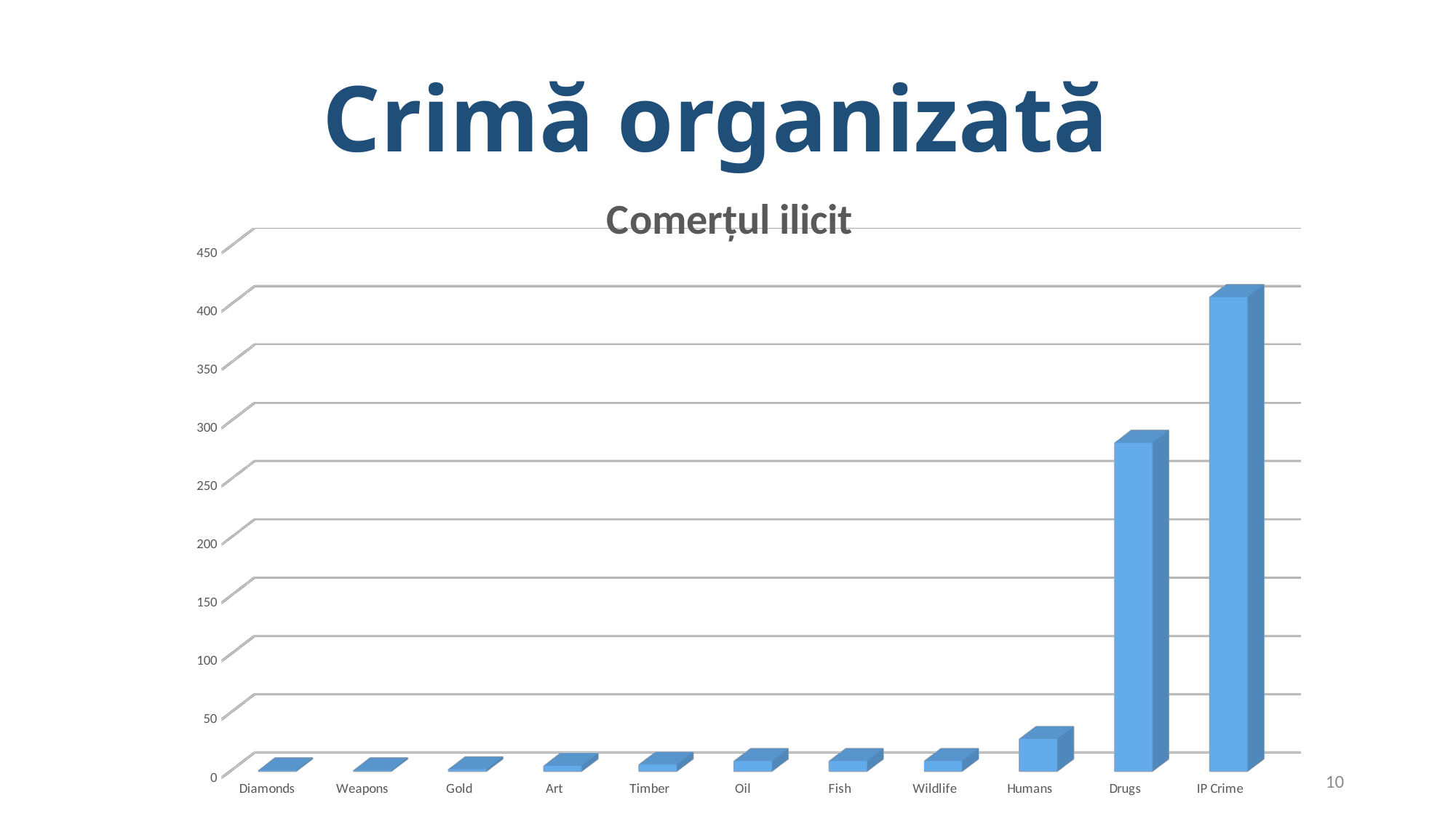
What is the highest value shown on the vertical axis of the chart? 450 What kind of chart is shown on the slide? bar chart Is the value for Diamonds greater or less than 50? less Is the value for IP Crime greater or less than 350? greater Is the value for Humans greater or less than 50? less What is the title of the chart? Comerțul ilicit Which category has the highest value in the chart? IP Crime How many categories are shown on the x axis of the chart? 11 Which is larger, the value for Drugs or the value for Humans? Drugs Which is larger, the value for IP Crime or the value for Drugs? IP Crime